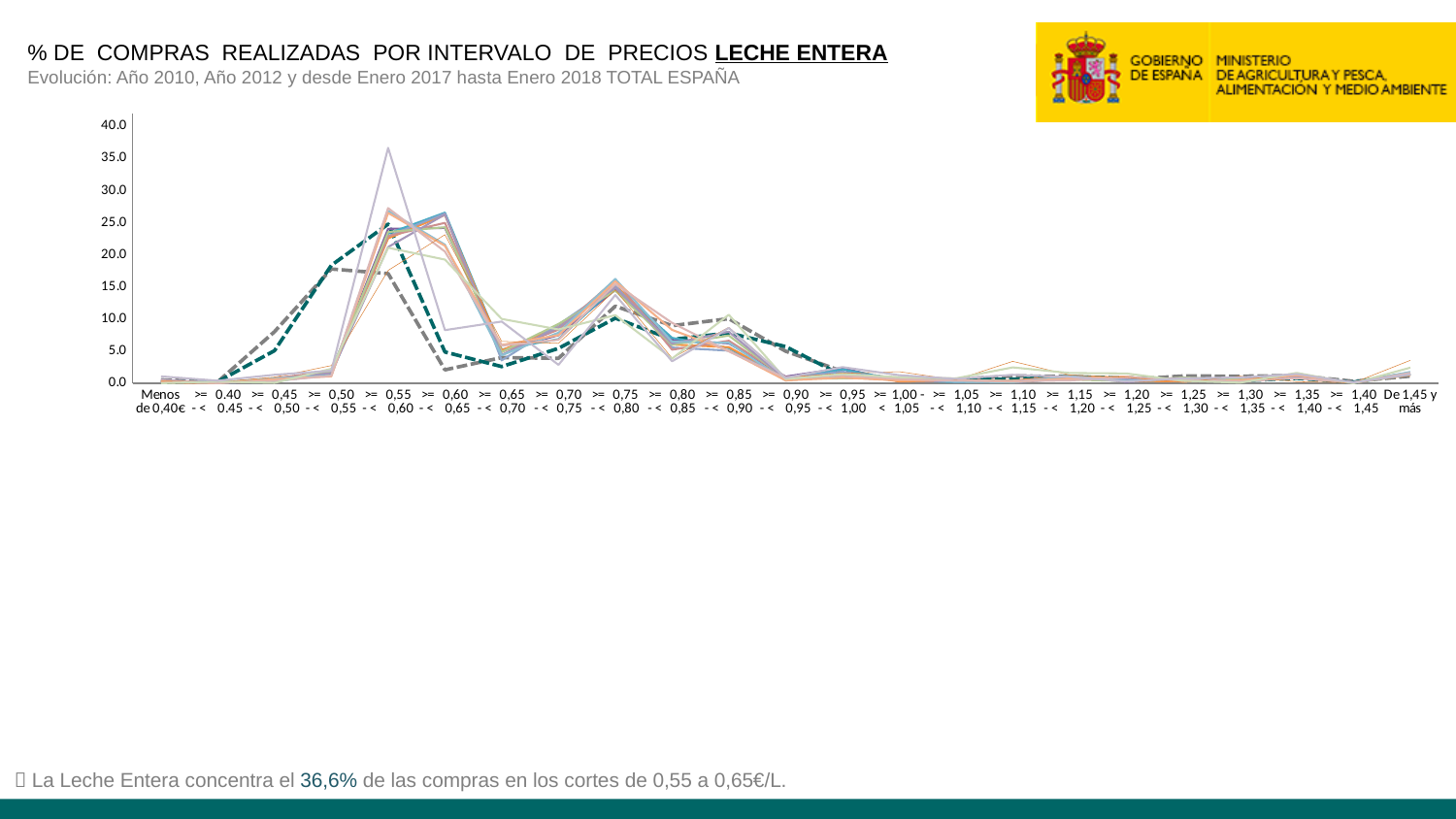
Is the highest point of the chart, in the 0,55 - < 0,60 interval, greater or less than 30? greater How many price intervals are shown along the x axis of the chart? 23 What kind of chart is shown on the slide? line chart Do the values generally rise or fall from the 0,60 - < 0,65 interval to the 0,65 - < 0,70 interval? fall Which product does the chart title refer to? LECHE ENTERA What is the highest value shown on the y axis of the chart? 40.0 Do the values generally rise or fall from the 0,45 - < 0,50 interval to the 0,55 - < 0,60 interval? rise Are the values for the 'Menos de 0,40€' interval greater or less than 5.0? less Are the values for the 1,00 - < 1,05 interval greater or less than 5.0? less In which price interval does the chart reach its highest point? 0,55 - < 0,60 Which interval has higher values, 0,55 - < 0,60 or 1,20 - < 1,25? 0,55 - < 0,60